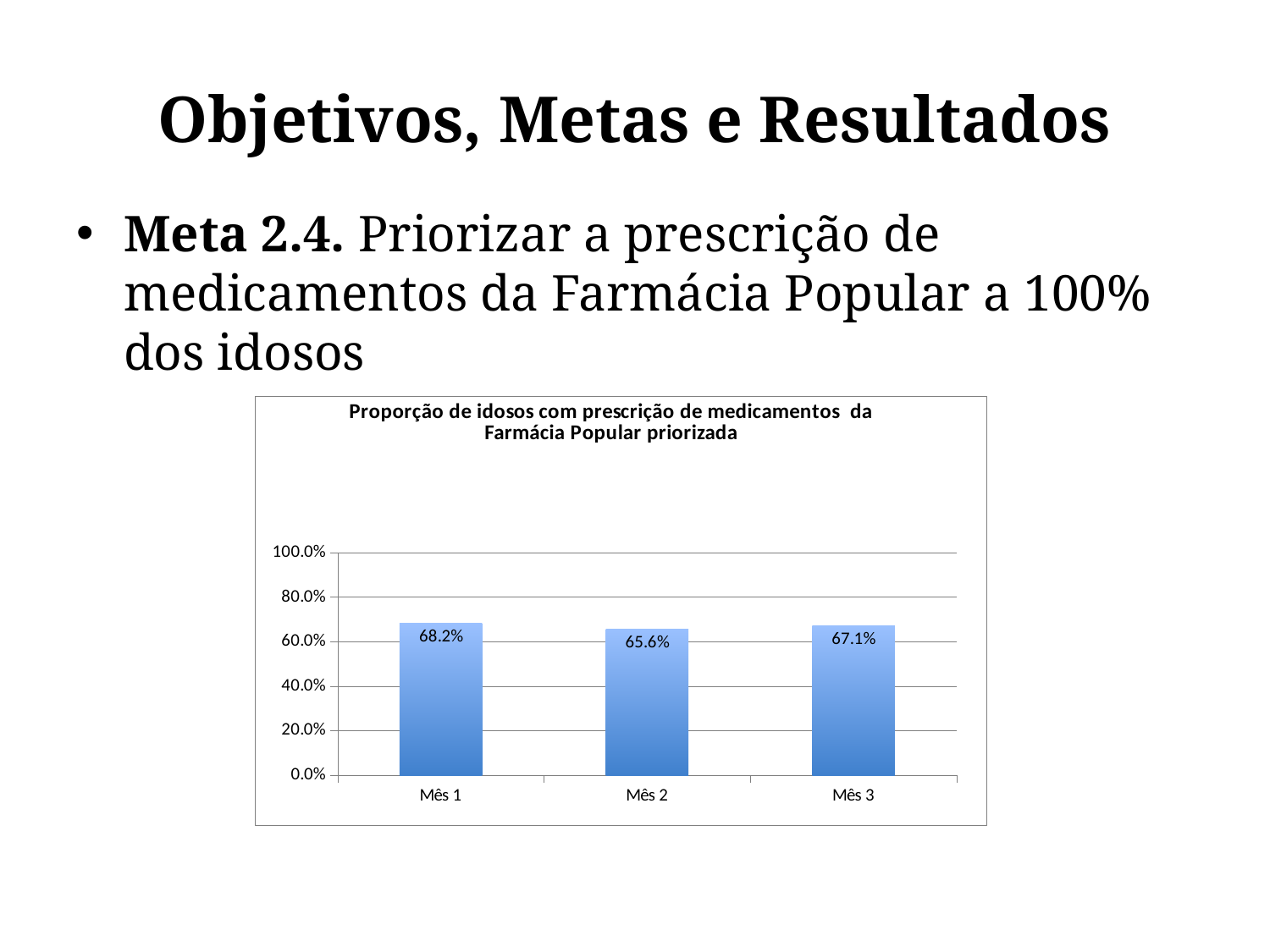
Which month has the lowest value? Mês 2 Which is larger, the value for Mês 1 or the value for Mês 3? Mês 1 What is the value for Mês 2? 65.6% What is the difference between the values for Mês 1 and Mês 2? 2.6% Is the value for Mês 2 greater or less than 80.0%? less What kind of chart is shown on the slide? bar chart What is the difference between the values for Mês 3 and Mês 2? 1.5% What is the title of the chart? Proporção de idosos com prescrição de medicamentos da Farmácia Popular priorizada What is the value for Mês 1? 68.2% What is the value for Mês 3? 67.1% How many months are shown on the x axis? 3 Which month has the highest value? Mês 1